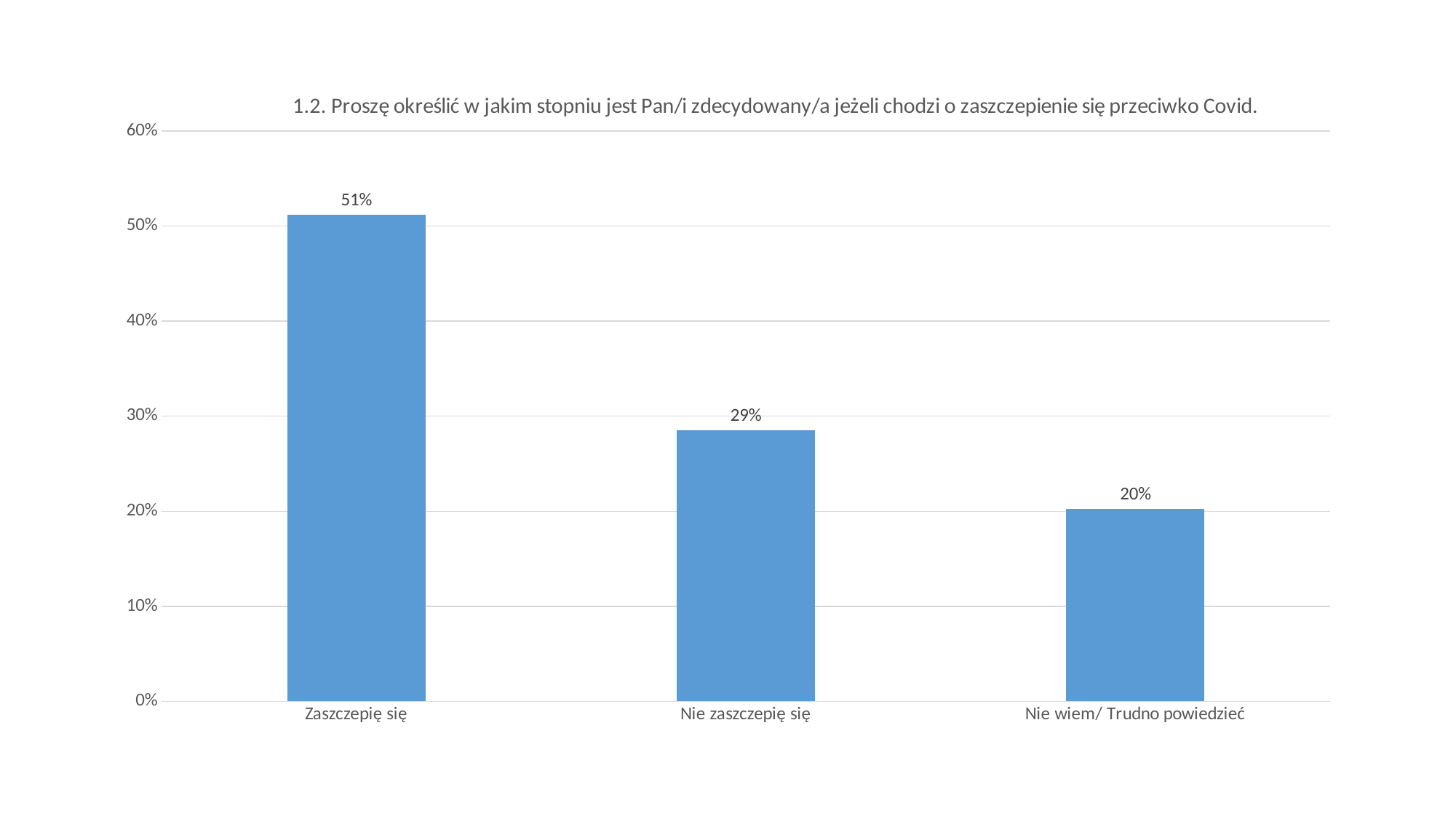
What kind of chart is shown on the slide? bar chart What is the difference between the values for "Nie zaszczepię się" and "Nie wiem/ Trudno powiedzieć"? 9% Is the value for "Zaszczepię się" greater or less than 40%? greater What is the value for "Nie zaszczepię się"? 29% Which is larger, the value for "Nie zaszczepię się" or the value for "Nie wiem/ Trudno powiedzieć"? Nie zaszczepię się What is the difference between the values for "Zaszczepię się" and "Nie zaszczepię się"? 22% How many categories are shown on the x axis? 3 What is the value for "Zaszczepię się"? 51% What is the value for "Nie wiem/ Trudno powiedzieć"? 20% Which category has the lowest value? Nie wiem/ Trudno powiedzieć Which category has the highest value? Zaszczepię się What is the title of the chart? 1.2. Proszę określić w jakim stopniu jest Pan/i zdecydowany/a jeżeli chodzi o zaszczepienie się przeciwko Covid.